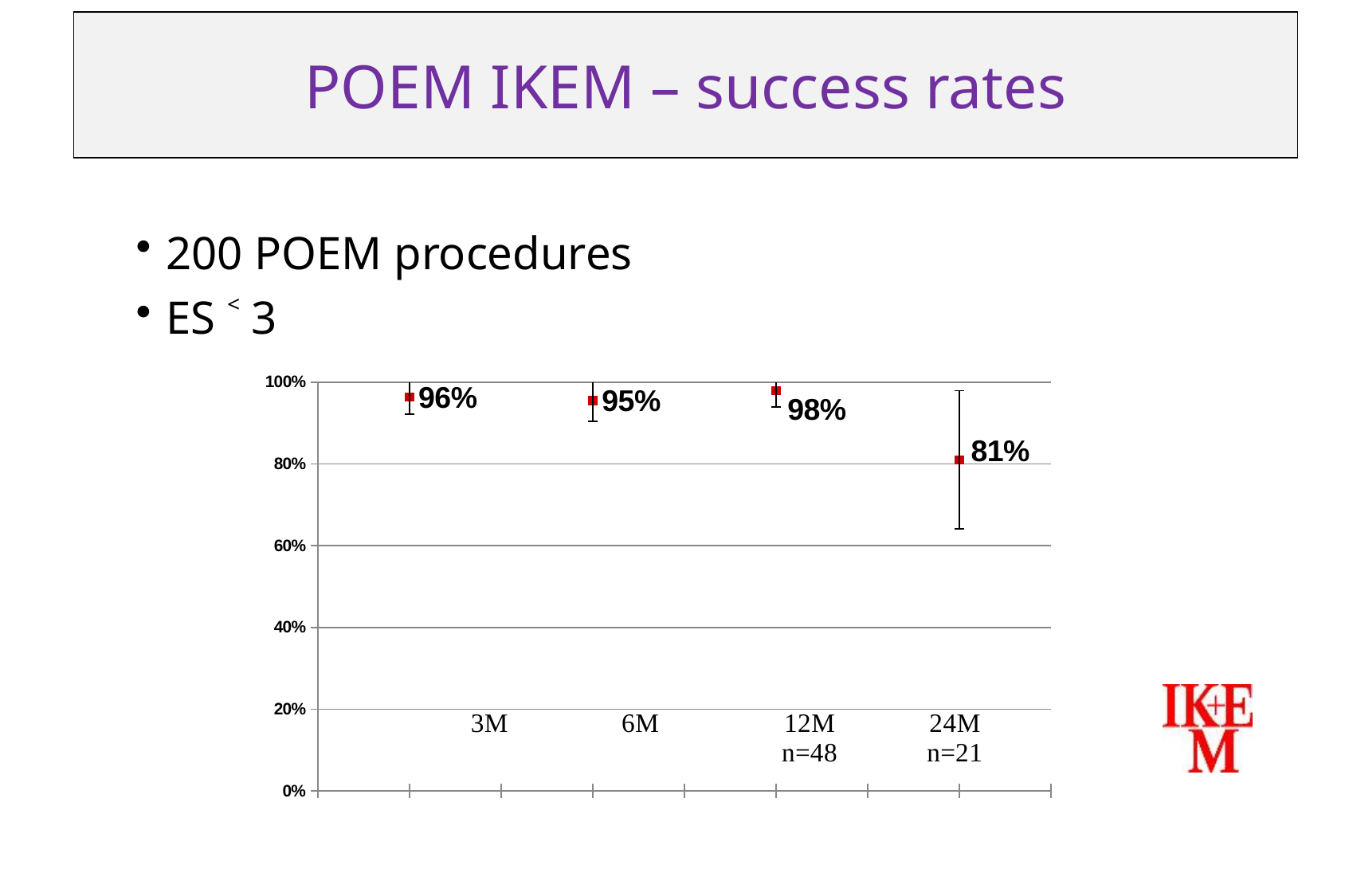
What is the success rate at 6M? 95% What kind of chart is shown on the slide? Scatter chart with error bars What is the sample size (n) shown for the 24M time point? n=21 What is the success rate at 3M? 96% What is the difference between the success rate at 12M and at 24M? 17% Is the success rate at 24M greater or less than 80%? greater What is the success rate at 24M? 81% How many time points are plotted in the chart? 4 At which time point is the success rate lowest? 24M What is the success rate at 12M? 98% At which time point is the success rate highest? 12M Which has a higher success rate, 3M or 24M? 3M